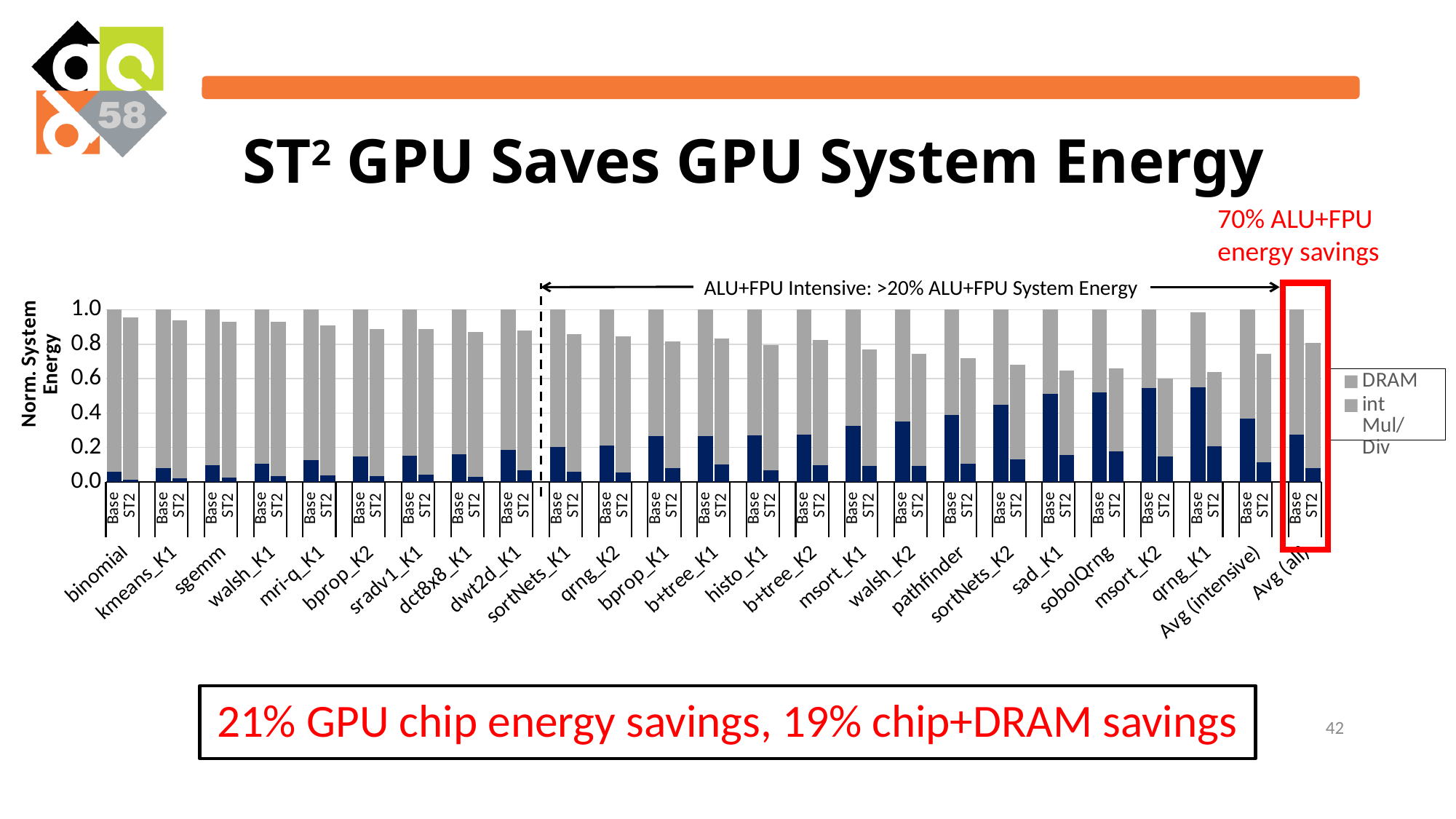
For sad_K1, which bar is taller, Base or ST2? Base Is the ST2 bar for sobolQrng greater or less than 0.6? greater Is the ST2 bar for Avg (intensive) greater or less than 0.8? less Is the ST2 bar for pathfinder greater or less than 0.8? less Which category on the x axis is highlighted with a red box? Avg (all) What is the y-axis title of the chart? Norm. System Energy How many benchmark categories (including the two averages) are shown along the x axis? 25 What is the value of the Base bar for binomial? 1.0 What kind of chart is shown on the slide? Stacked bar chart Do the ST2 bars generally rise or fall moving from binomial to msort_K2 along the x axis? fall